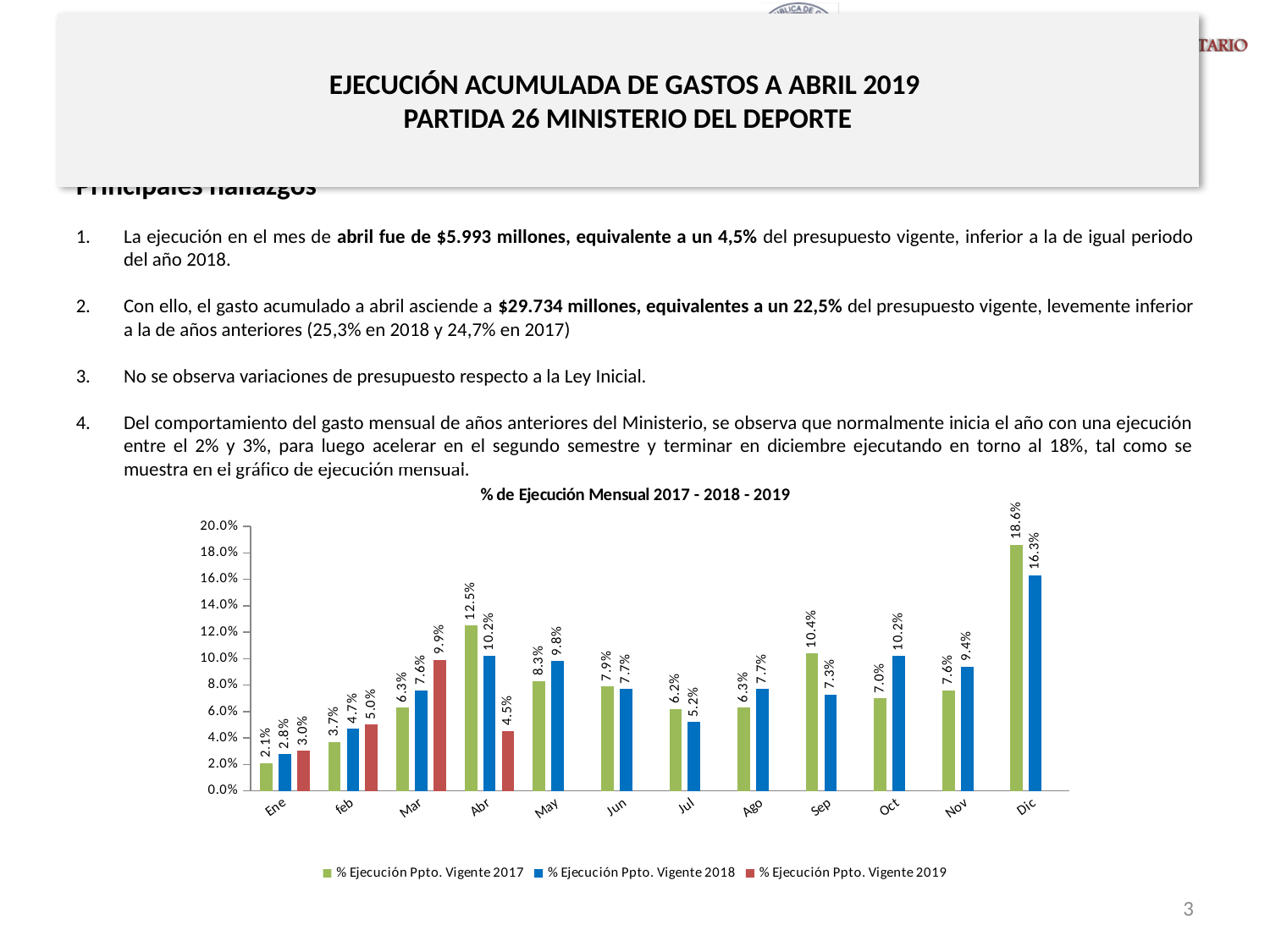
Which is larger in Sep: the 2017 value or the 2018 value? 2017 (10.4%) What is the value for % Ejecución Ppto. Vigente 2019 in Mar? 9.9% What is the value for % Ejecución Ppto. Vigente 2017 in Abr? 12.5% What is the value for % Ejecución Ppto. Vigente 2018 in Dic? 16.3% How many series does the legend list? 3 Is the value for % Ejecución Ppto. Vigente 2017 in Abr greater or less than 10.0%? greater What is the title of the chart? % de Ejecución Mensual 2017 - 2018 - 2019 Which month has the highest value for % Ejecución Ppto. Vigente 2017? Dic What is the difference between the 2017 and 2018 values in Dic? 2.3% Which month has the lowest value for % Ejecución Ppto. Vigente 2018? Ene What kind of chart is shown? Bar chart How many months are shown on the x axis? 12